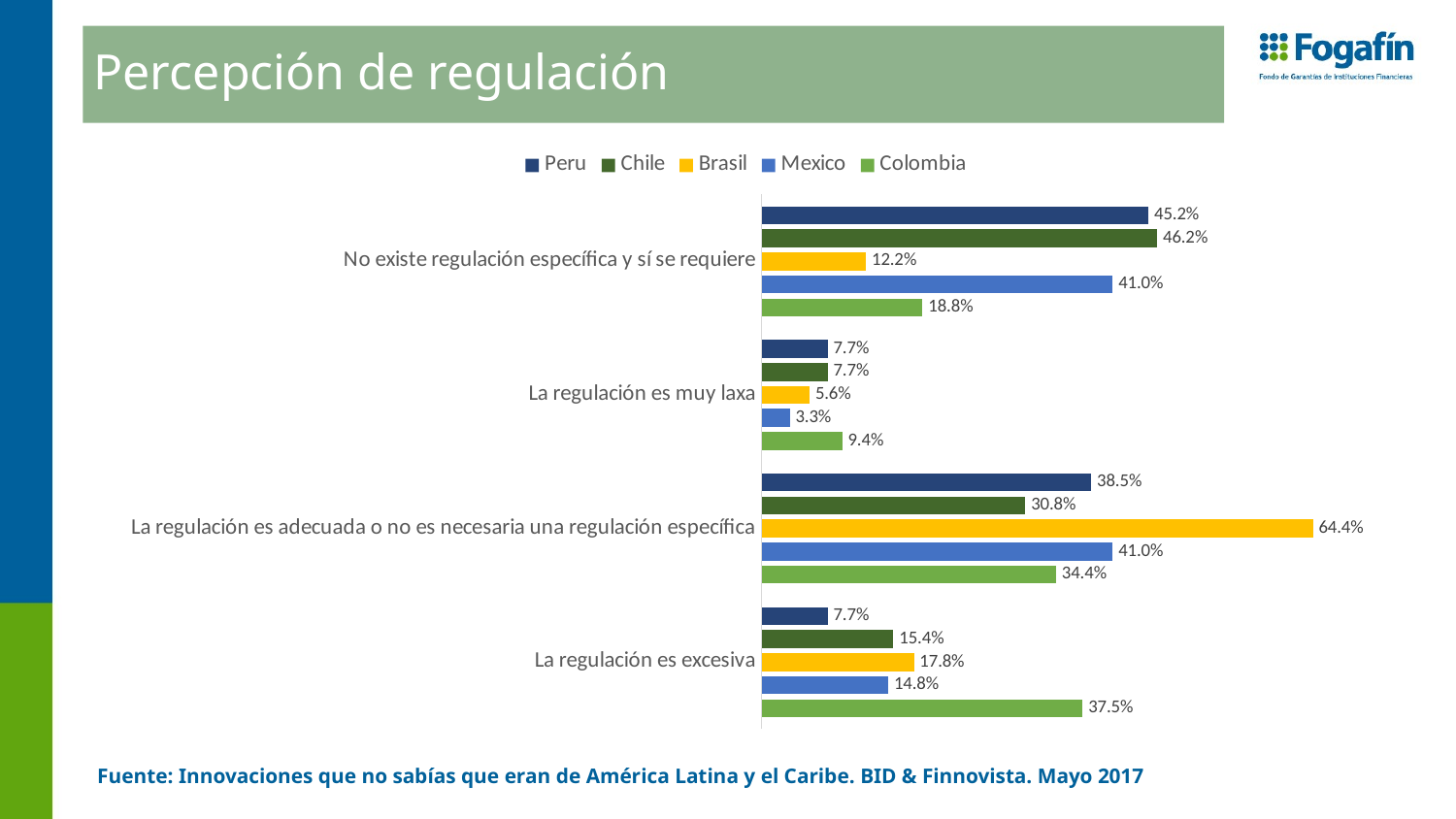
In the category "La regulación es excesiva", which is larger: the value for Brasil or the value for Mexico? Brasil Which country has the highest value in the category "No existe regulación específica y sí se requiere"? Chile Which country has the lowest value in the category "La regulación es muy laxa"? Mexico What is the title of the slide containing the chart? Percepción de regulación What kind of chart is shown on the slide? Bar chart How many series does the legend list? 5 What is the value for Colombia in the category "La regulación es excesiva"? 37.5% What is the value for Mexico in the category "No existe regulación específica y sí se requiere"? 41.0% How many categories are shown on the chart? 4 What is the difference between the Chile and Peru values in the category "No existe regulación específica y sí se requiere"? 1.0% What is the difference between the Colombia and Peru values in the category "La regulación es excesiva"? 29.8% What is the value for Brasil in the category "La regulación es adecuada o no es necesaria una regulación específica"? 64.4%